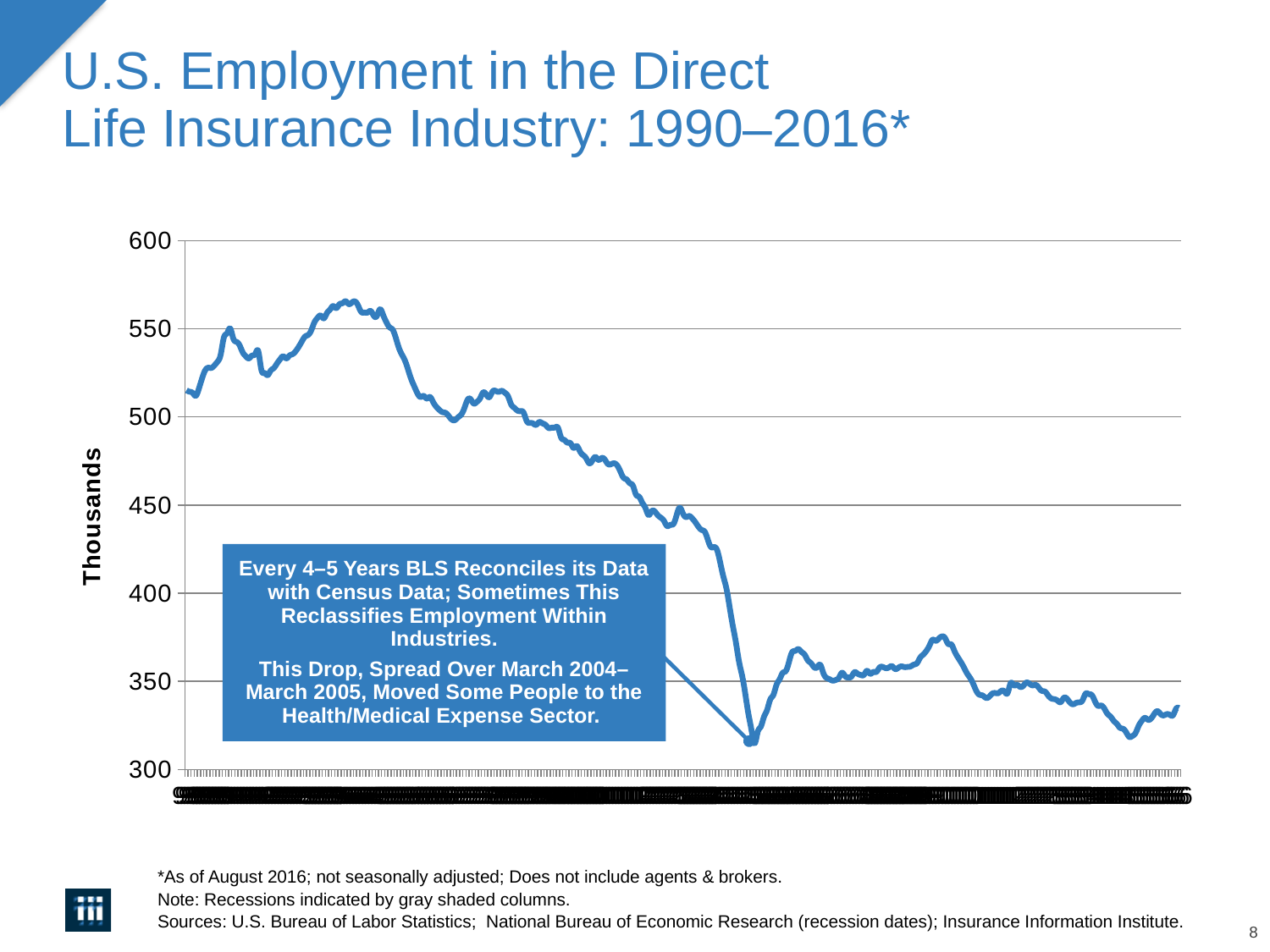
What kind of chart is shown on the slide? Line chart Overall, do the values rise or fall from the left end of the chart to the right end? Fall Is the highest point on the line greater or less than 600? less What is the title of the chart on the slide? U.S. Employment in the Direct Life Insurance Industry: 1990–2016* Is the value at the start of the series (left end of the line) greater or less than 500? greater What is the label on the vertical axis of the chart? Thousands Is the value at the end of the series (right end of the line) greater or less than 350? less